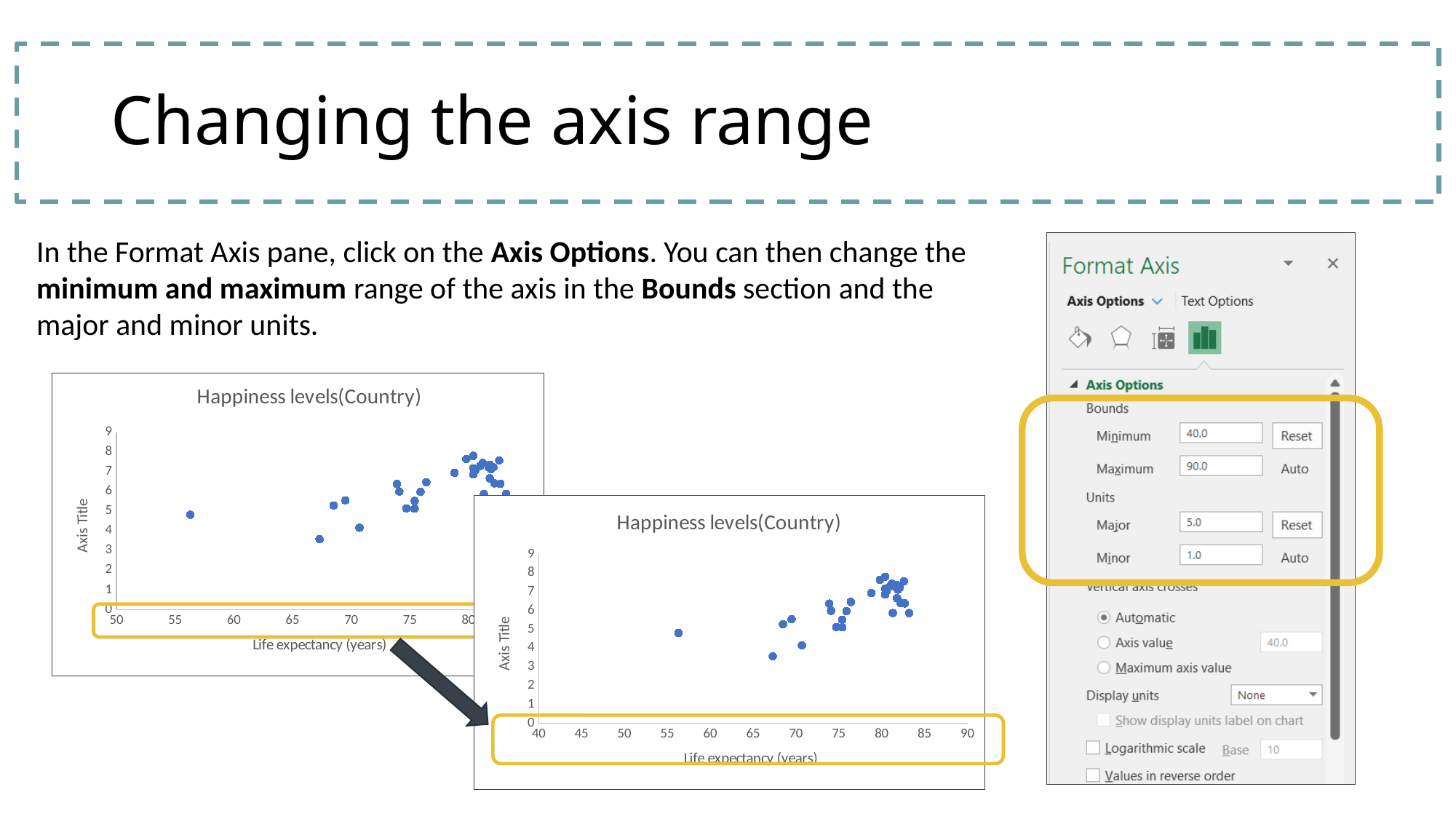
In the left chart, is the y value of the leftmost point (near 56 years) greater or less than 4? greater What is the x-axis label on the charts? Life expectancy (years) What is the title of the charts on the slide? Happiness levels(Country) In the left chart, is the y value of the lowest point (near 68 years) greater or less than 4? less What kind of chart is shown on the slide? Scatter chart In the charts, do happiness values generally rise or fall as life expectancy increases along the x axis? Rise